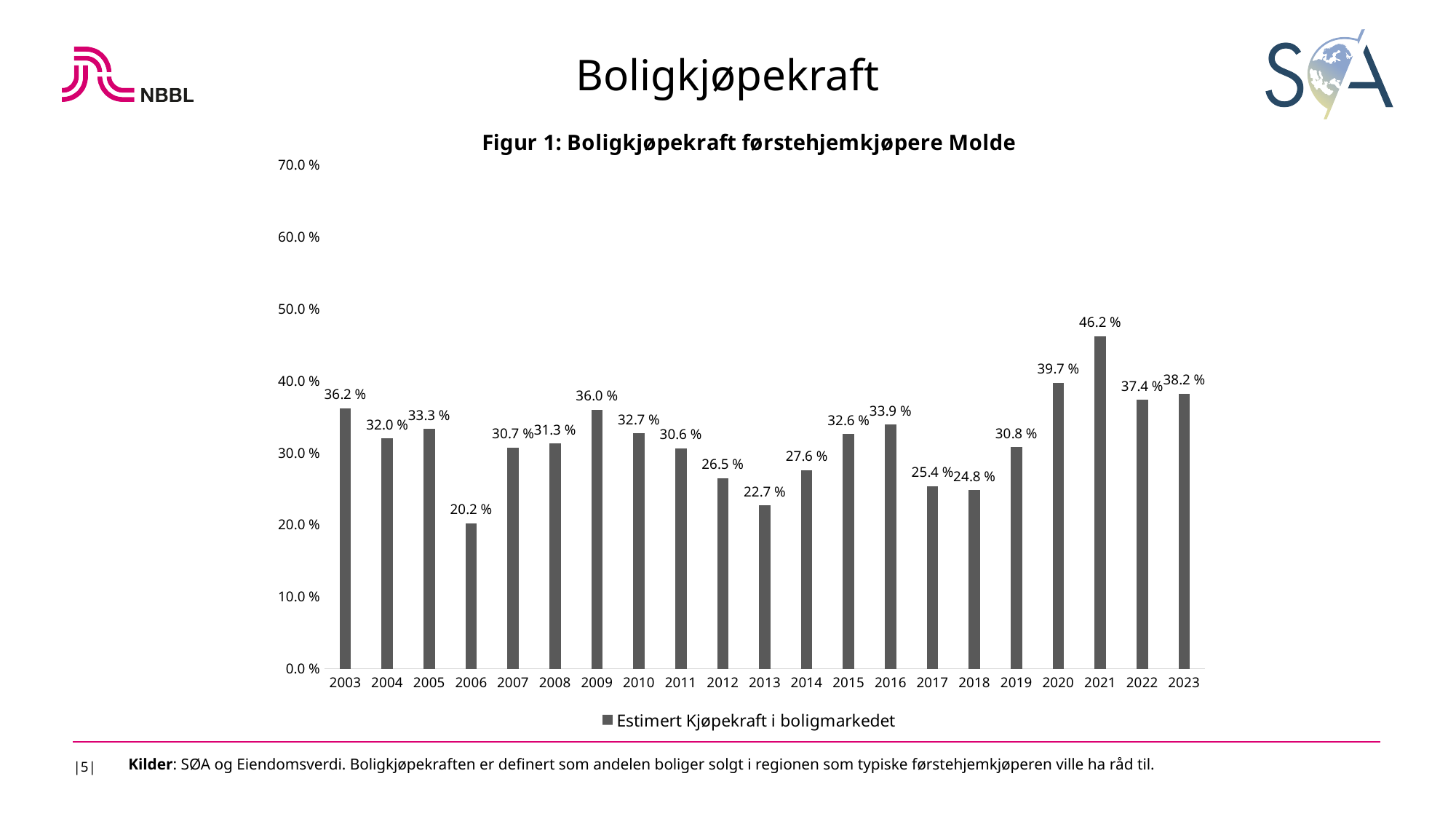
What is the value for 2006 in the chart? 20.2 % Which is larger, the value for 2006 or the value for 2013? 2013 What is the difference between the values for 2021 and 2020? 6.5 percentage points What is the value for 2013 in the chart? 22.7 % Which year has the lowest value in the chart? 2006 Which year has the highest value in the chart? 2021 How many series does the legend list? 1 What kind of chart is shown on the slide? Bar chart What is the value for 2021 in the chart? 46.2 % Is the value for 2020 greater or less than 30.0 %? greater How many years are shown on the x axis of the chart? 21 What is the difference between the values for 2023 and 2022? 0.8 percentage points